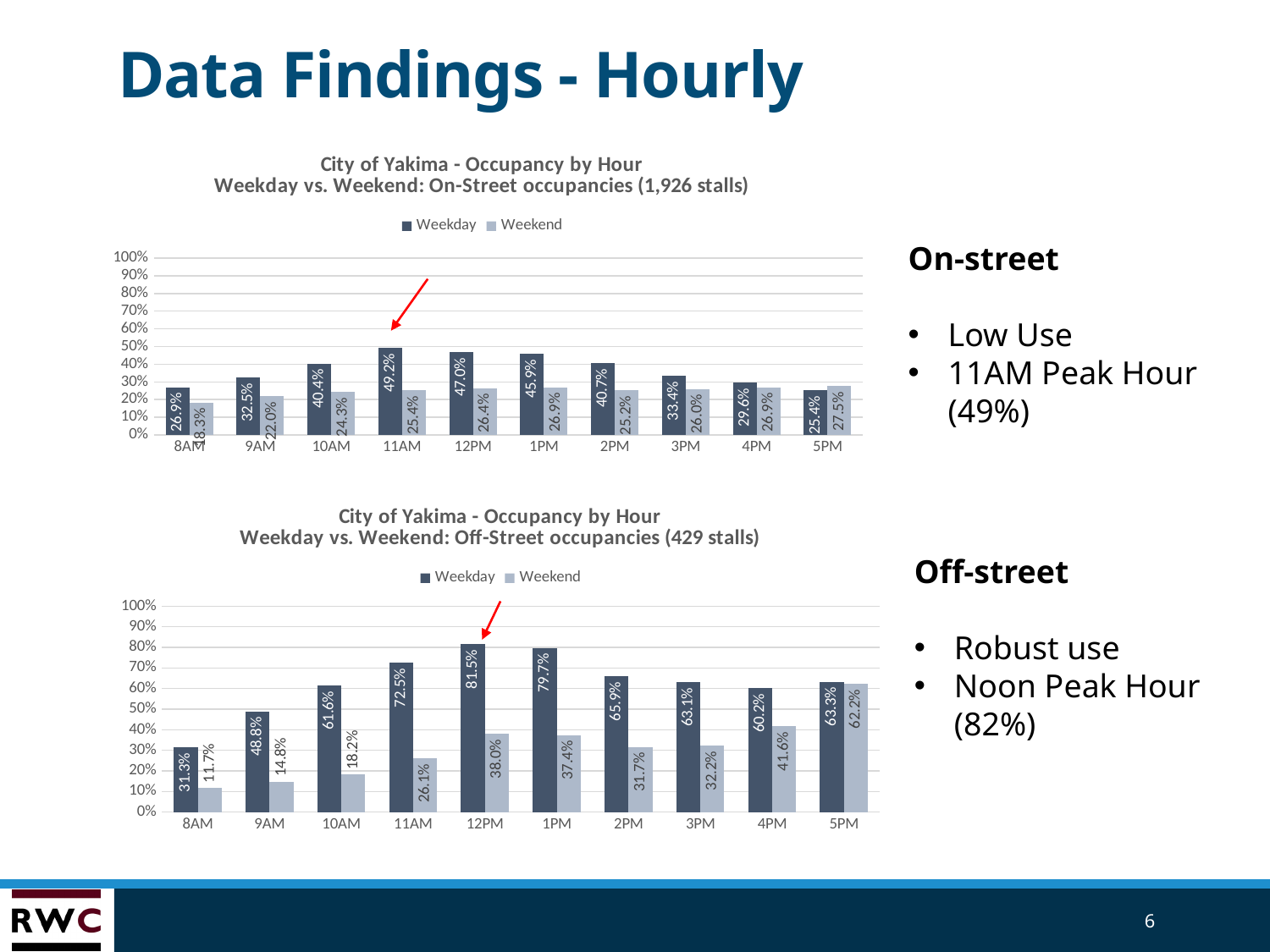
In the Off-Street occupancies chart, which hour has the lowest Weekday value? 8AM In the Off-Street occupancies chart, what is the Weekday value at 12PM? 81.5% In the On-Street occupancies chart, which is larger at 5PM, the Weekday or the Weekend value? Weekend In the On-Street occupancies chart, which hour has the lowest Weekend value? 8AM In the On-Street occupancies chart, what is the difference between the Weekday and Weekend values at 12PM? 20.6% In the On-Street occupancies chart, what is the Weekday value at 11AM? 49.2% In the On-Street occupancies chart, what is the Weekend value at 8AM? 18.3% How many series does the legend of the On-Street occupancies chart list? 2 In the Off-Street occupancies chart, what is the difference between the Weekday and Weekend values at 8AM? 19.6% How many hours are shown on the x axis of the Off-Street occupancies chart? 10 In the Off-Street occupancies chart, what is the Weekend value at 5PM? 62.2% In the On-Street occupancies chart, which hour has the highest Weekday value? 11AM